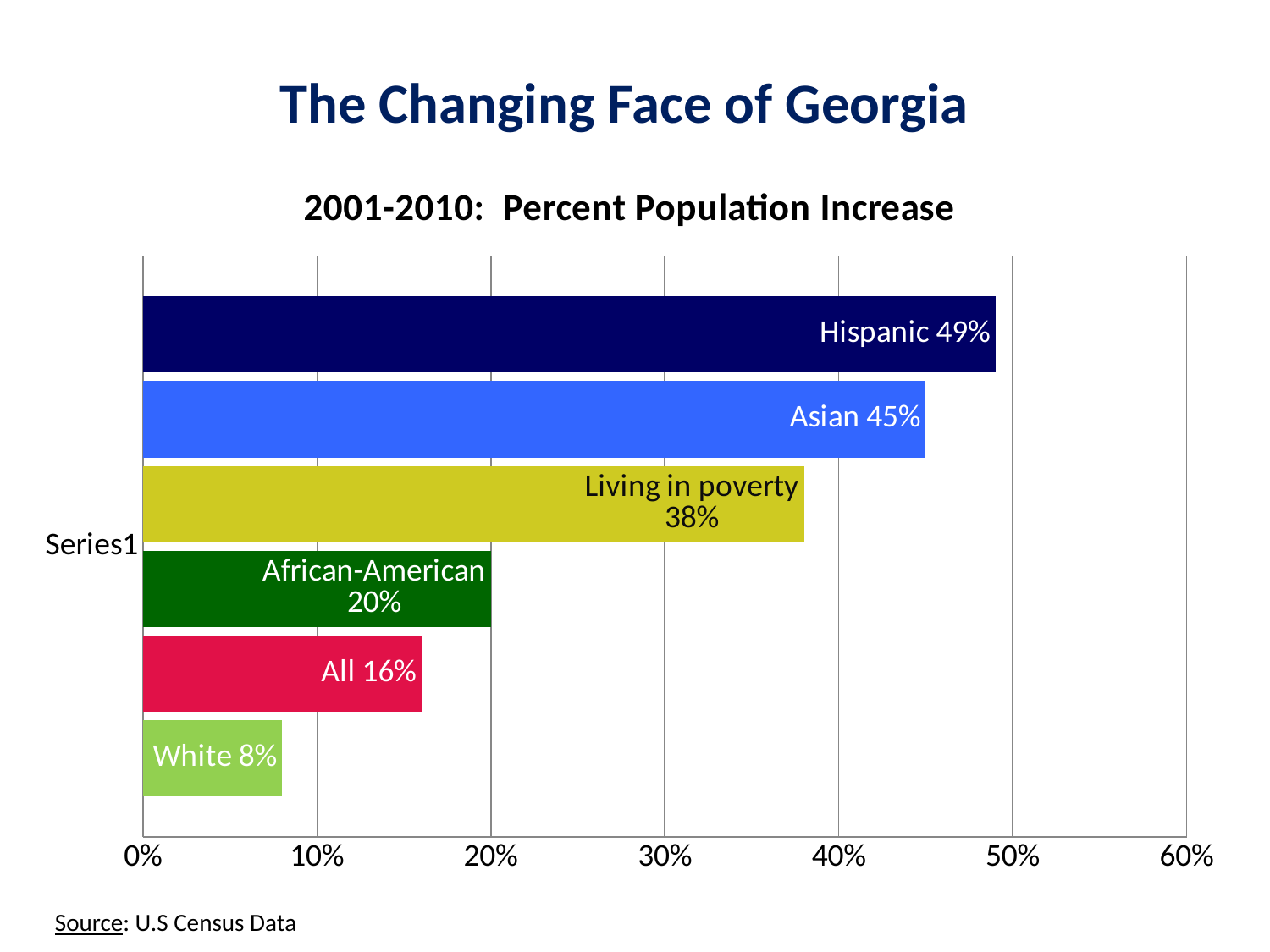
What is the difference between the Hispanic and Asian percent population increases? 4% What is the percent population increase for White? 8% Is the value for Living in poverty greater or less than 40%? less What kind of chart is shown on the slide? bar chart Which group has the lowest percent population increase? White Which group has the highest percent population increase? Hispanic What is the title of the chart? 2001-2010: Percent Population Increase How many bars are shown in the chart? 6 What is the percent population increase for Hispanic? 49% Which is larger, the percent increase for Asian or for Living in poverty? Asian What is the difference between the Living in poverty and All percent population increases? 22% What is the percent population increase for African-American? 20%